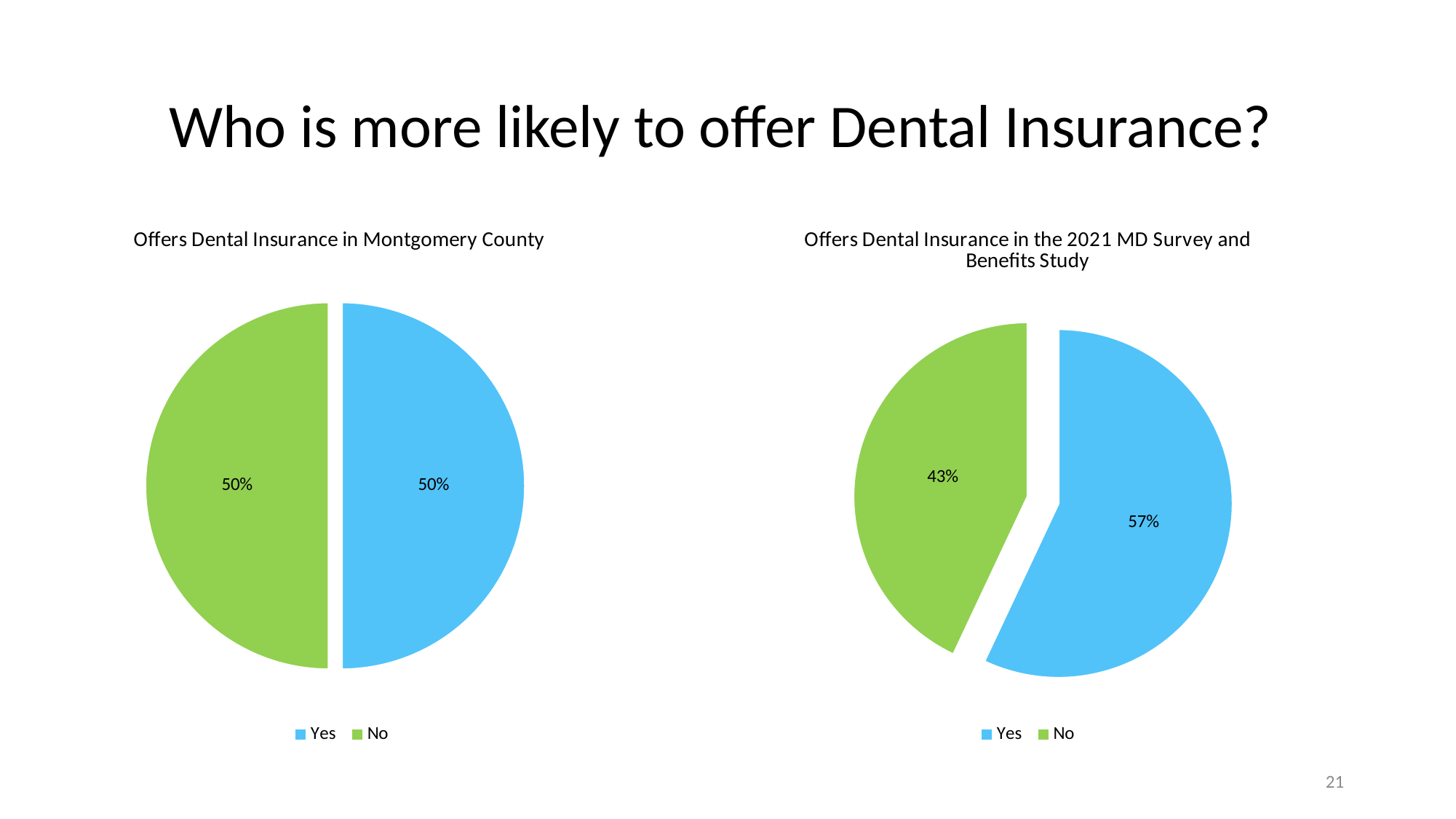
How many entries does the legend of the 'Offers Dental Insurance in the 2021 MD Survey and Benefits Study' chart list? 2 In the 'Offers Dental Insurance in the 2021 MD Survey and Benefits Study' chart, which slice is the largest? Yes What kind of chart is the 'Offers Dental Insurance in Montgomery County' chart? Pie chart In the 'Offers Dental Insurance in the 2021 MD Survey and Benefits Study' chart, is the Yes share greater or less than 50%? greater In the 'Offers Dental Insurance in the 2021 MD Survey and Benefits Study' chart, which slice is the smallest? No In the 'Offers Dental Insurance in Montgomery County' chart, what share is labelled for Yes? 50% In the 'Offers Dental Insurance in the 2021 MD Survey and Benefits Study' chart, what share is labelled for No? 43% In the 'Offers Dental Insurance in Montgomery County' chart, what colour is the Yes slice? Blue In the 'Offers Dental Insurance in the 2021 MD Survey and Benefits Study' chart, what share is labelled for Yes? 57% In the 'Offers Dental Insurance in the 2021 MD Survey and Benefits Study' chart, what is the difference between the Yes and No shares? 14% How many slices does the 'Offers Dental Insurance in Montgomery County' pie chart have? 2 In the 'Offers Dental Insurance in Montgomery County' chart, what share is labelled for No? 50%